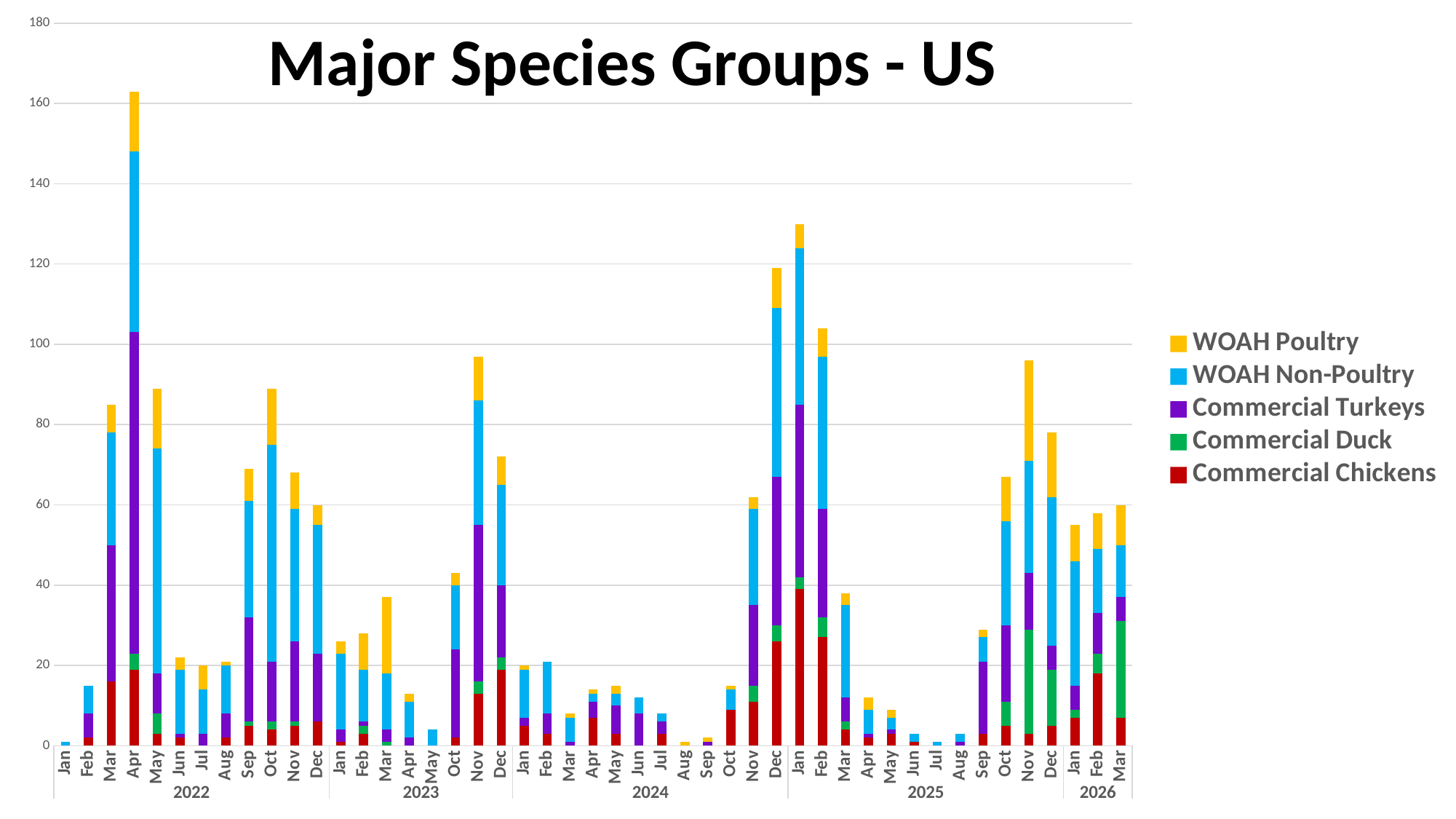
How many series does the legend list? 5 Which month has the highest total bar? Apr 2022 Is the total for Apr 2022 greater or less than 140? greater Is the total for Nov 2025 greater or less than 80? greater Do the total bars rise or fall from Jan 2026 to Mar 2026? rise Which has the larger total, Oct 2022 or Nov 2022? Oct 2022 What is the title of the chart? Major Species Groups - US Is the total for Jan 2025 greater or less than 120? greater How many monthly bars are plotted on the chart? 47 Which series is shown in red in the legend? Commercial Chickens What kind of chart is shown on the slide? Stacked bar chart